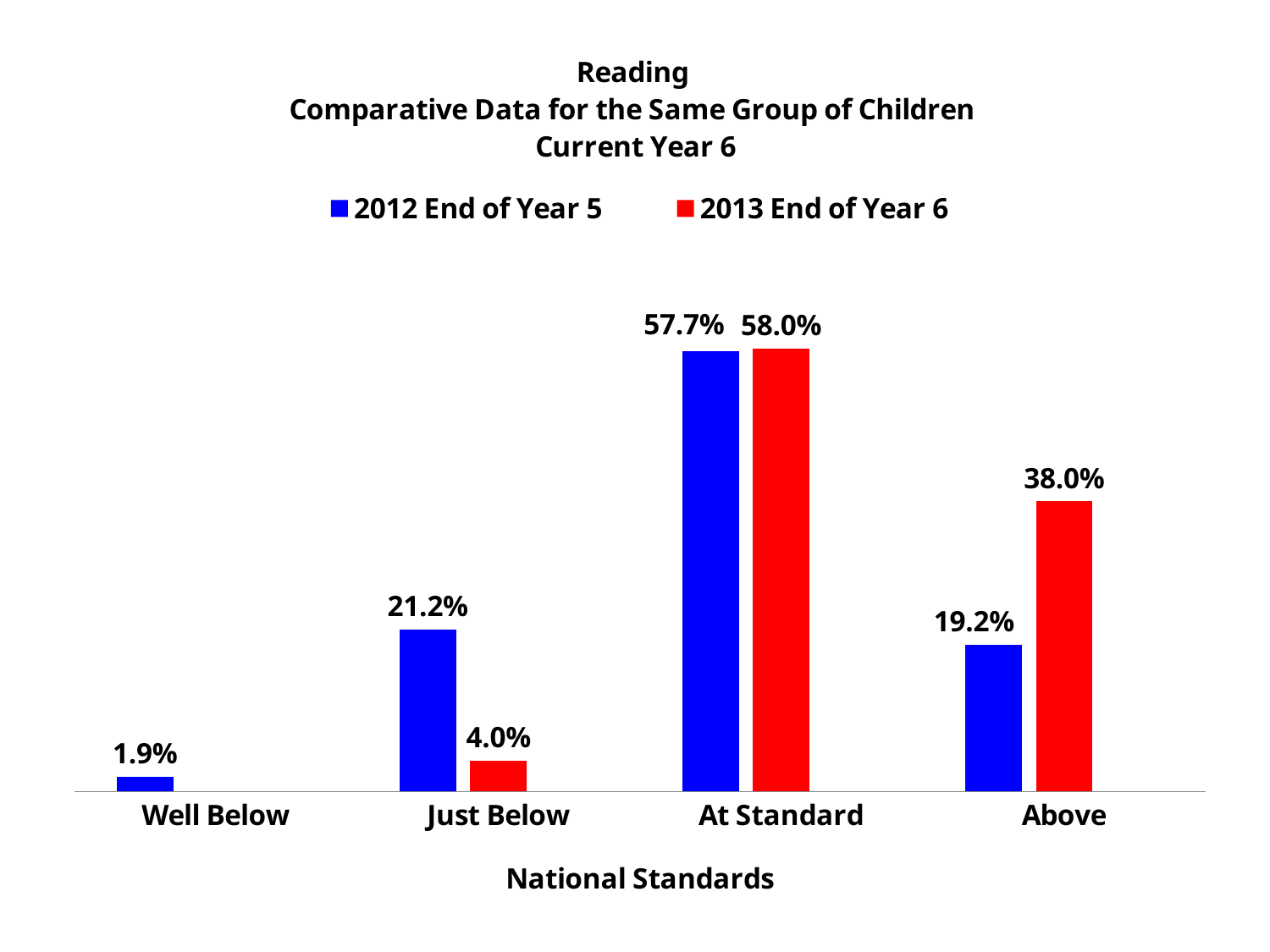
What is the value for At Standard in the 2013 End of Year 6 series? 58.0% How many categories are shown on the x axis? 4 What is the difference between the 2012 End of Year 5 and 2013 End of Year 6 values for Just Below? 17.2% Which is larger for Just Below: the 2012 End of Year 5 value or the 2013 End of Year 6 value? 2012 End of Year 5 How many series does the legend list? 2 What is the value for Just Below in the 2012 End of Year 5 series? 21.2% Which category has the highest value in the 2013 End of Year 6 series? At Standard What is the value for Above in the 2013 End of Year 6 series? 38.0% Which category has the lowest value in the 2012 End of Year 5 series? Well Below What kind of chart is shown on the slide? Bar chart What is the difference between the 2013 End of Year 6 and 2012 End of Year 5 values for Above? 18.8% What is the value for Well Below in the 2012 End of Year 5 series? 1.9%